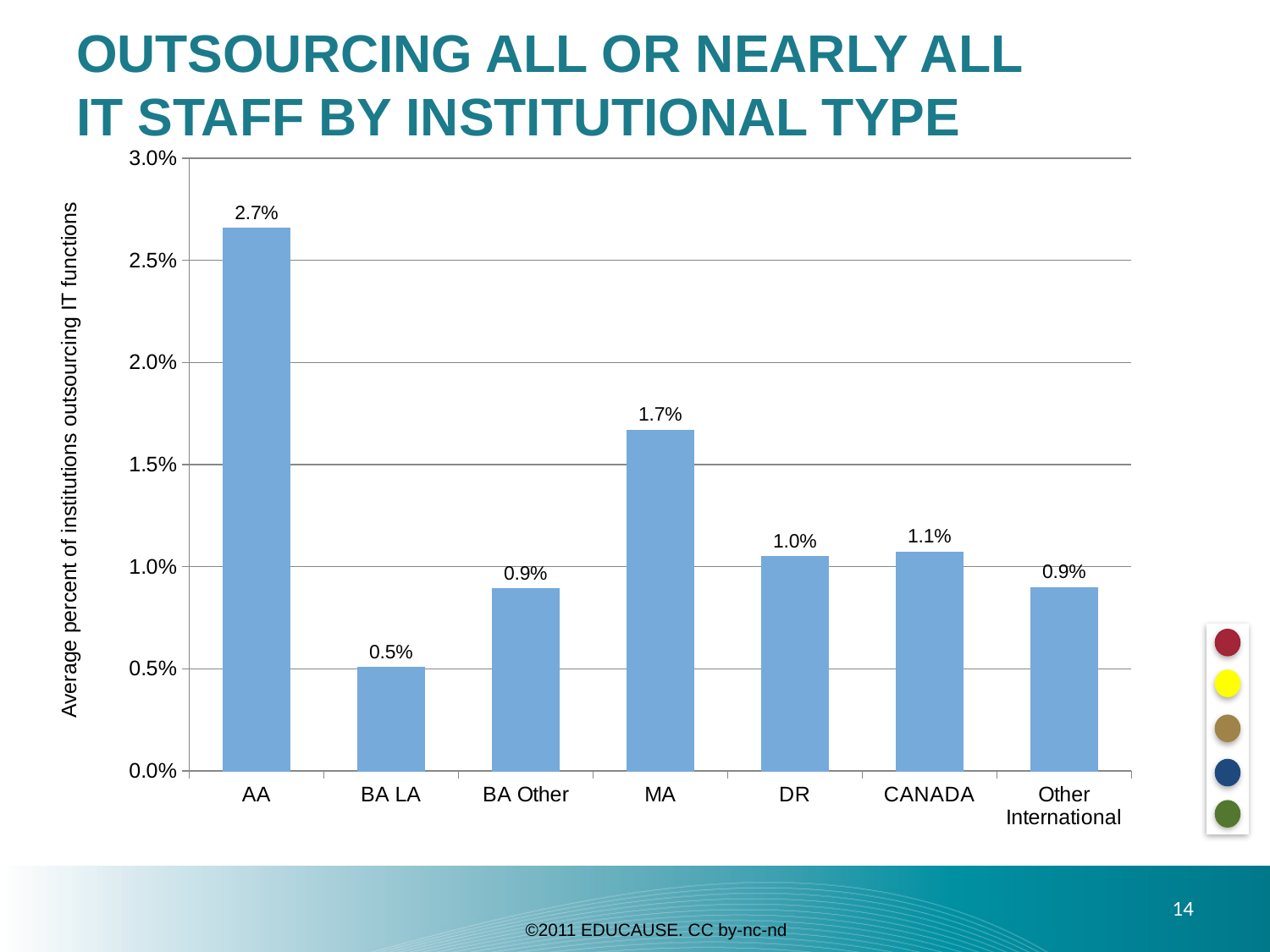
What is the difference between the values for AA and MA? 1.0% What is the value for AA? 2.7% What is the value for BA LA? 0.5% Which is larger, the value for MA or the value for DR? MA Which institutional type has the lowest value? BA LA Is the value for DR greater or less than 1.5%? less Which institutional type has the highest value? AA How many institutional types are shown on the x axis? 7 What is the value for CANADA? 1.1% What is the label of the vertical axis? Average percent of institutions outsourcing IT functions What kind of chart is shown on the slide? bar chart What is the value for MA? 1.7%